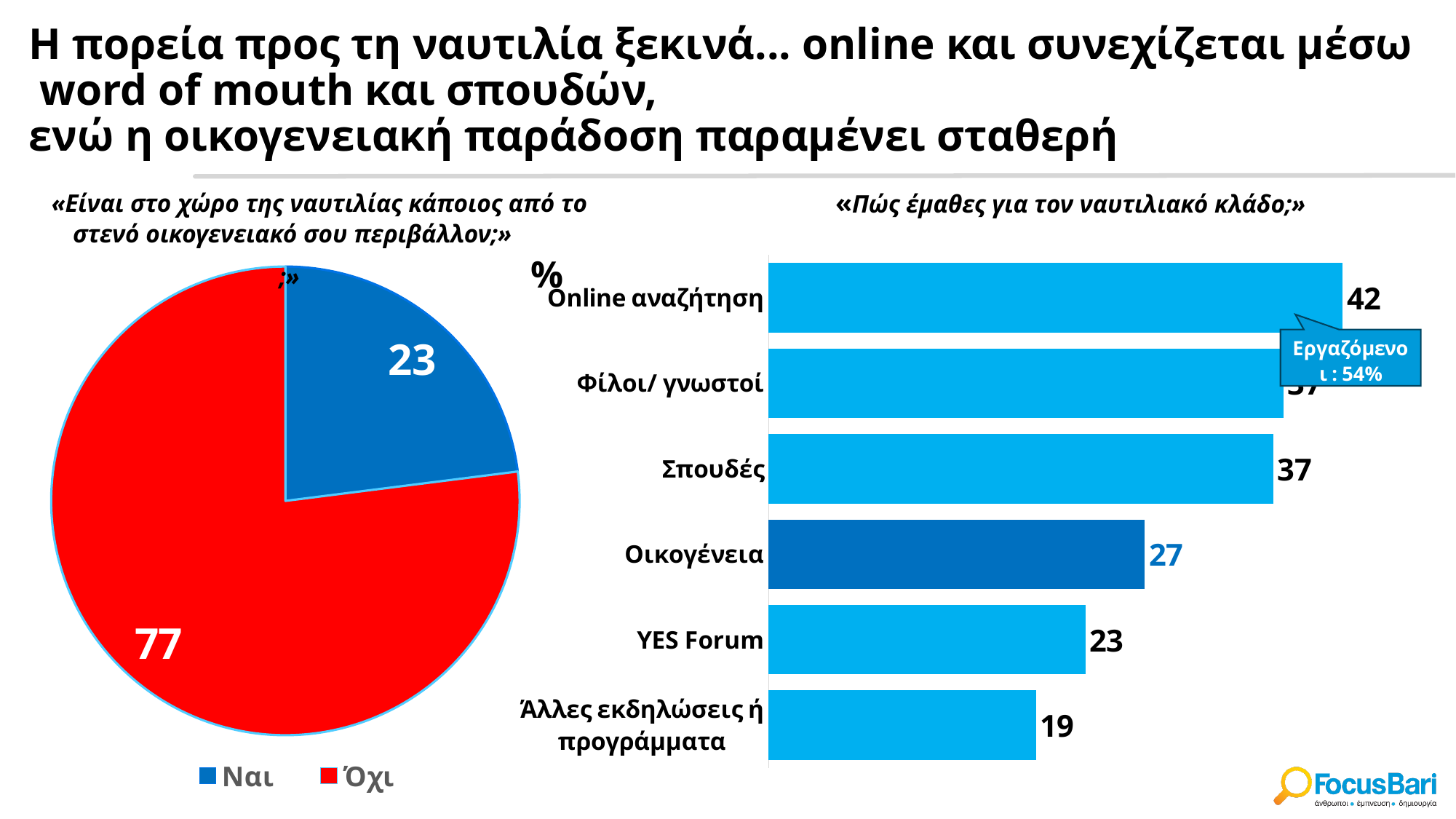
In the right bar chart, how many categories are shown? 6 In the left pie chart, which slice is larger, Ναι or Όχι? Όχι In the left pie chart, what is the difference between Όχι and Ναι? 54 In the right bar chart, what is the difference between Σπουδές and YES Forum? 14 In the right bar chart, what is the value for Οικογένεια? 27 In the right bar chart, which category has the lowest value? Άλλες εκδηλώσεις ή προγράμματα In the right bar chart, which category has the highest value? Online αναζήτηση In the right bar chart, what is the value for Online αναζήτηση? 42 In the left pie chart, what is the value for Ναι? 23 In the left pie chart, what is the value for Όχι? 77 What kind of chart is the right chart titled «Πώς έμαθες για τον ναυτιλιακό κλάδο;»? bar chart What kind of chart is the left chart titled «Είναι στο χώρο της ναυτιλίας κάποιος από το στενό οικογενειακό σου περιβάλλον;»? pie chart